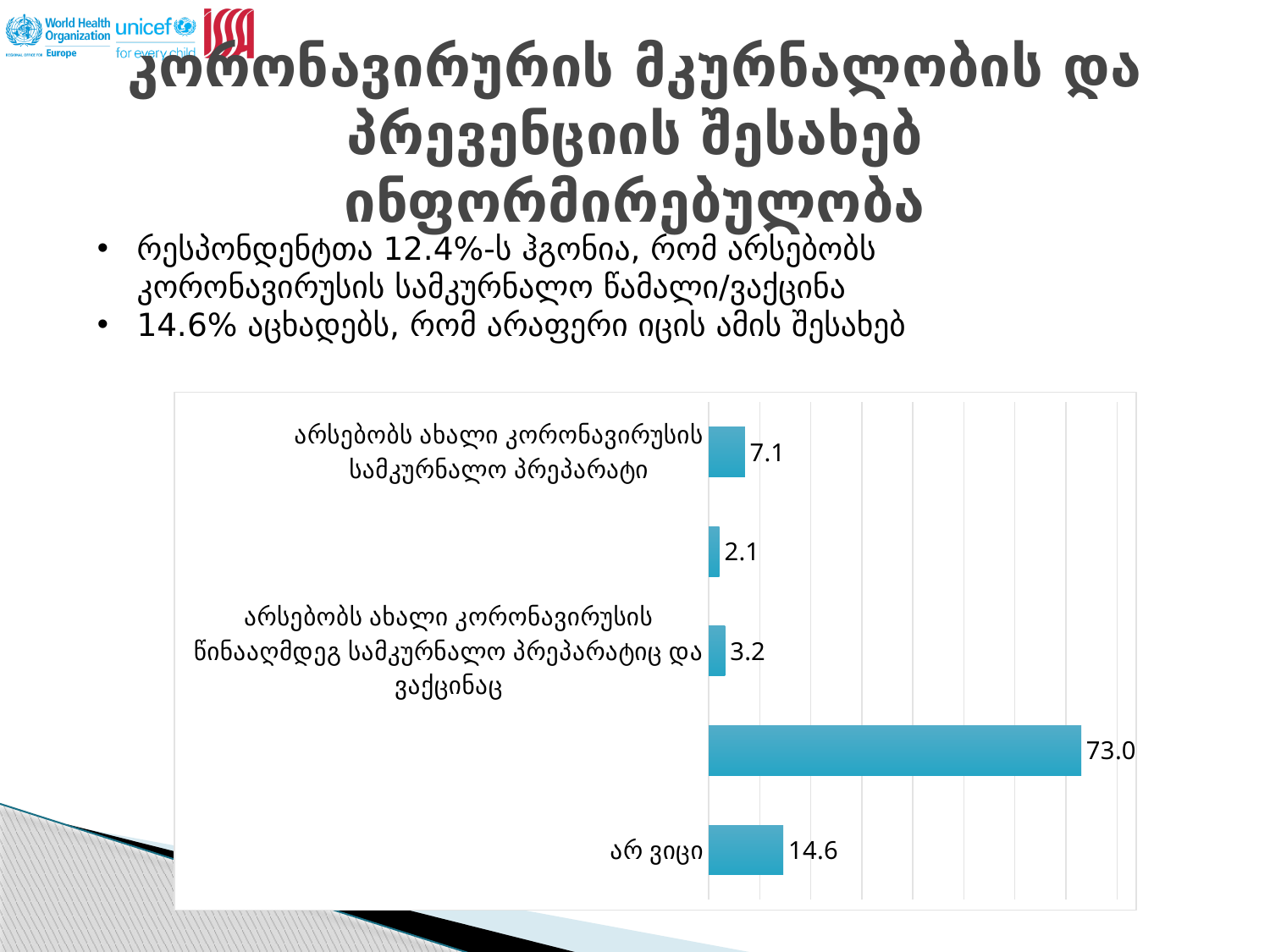
How many bars does the chart show? 5 What is the difference between the value for "არსებობს ახალი კორონავირუსის სამკურნალო პრეპარატი" and the value for "არსებობს ახალი კორონავირუსის წინააღმდეგ სამკურნალო პრეპარატიც და ვაქცინაც"? 3.9 What is the smallest value shown in the chart? 2.1 Which is larger: the value for "არ ვიცი" or the value for "არსებობს ახალი კორონავირუსის სამკურნალო პრეპარატი"? არ ვიცი Which is larger: the value for "არსებობს ახალი კორონავირუსის სამკურნალო პრეპარატი" or the value for "არსებობს ახალი კორონავირუსის წინააღმდეგ სამკურნალო პრეპარატიც და ვაქცინაც"? არსებობს ახალი კორონავირუსის სამკურნალო პრეპარატი What is the difference between the value for "არ ვიცი" and the value for "არსებობს ახალი კორონავირუსის სამკურნალო პრეპარატი"? 7.5 What is the value for "არ ვიცი"? 14.6 What type of chart is shown on the slide? bar chart What is the value of the longest bar in the chart? 73.0 What is the value for "არსებობს ახალი კორონავირუსის სამკურნალო პრეპარატი"? 7.1 Are the bars in the chart horizontal or vertical? horizontal What is the value for "არსებობს ახალი კორონავირუსის წინააღმდეგ სამკურნალო პრეპარატიც და ვაქცინაც"? 3.2